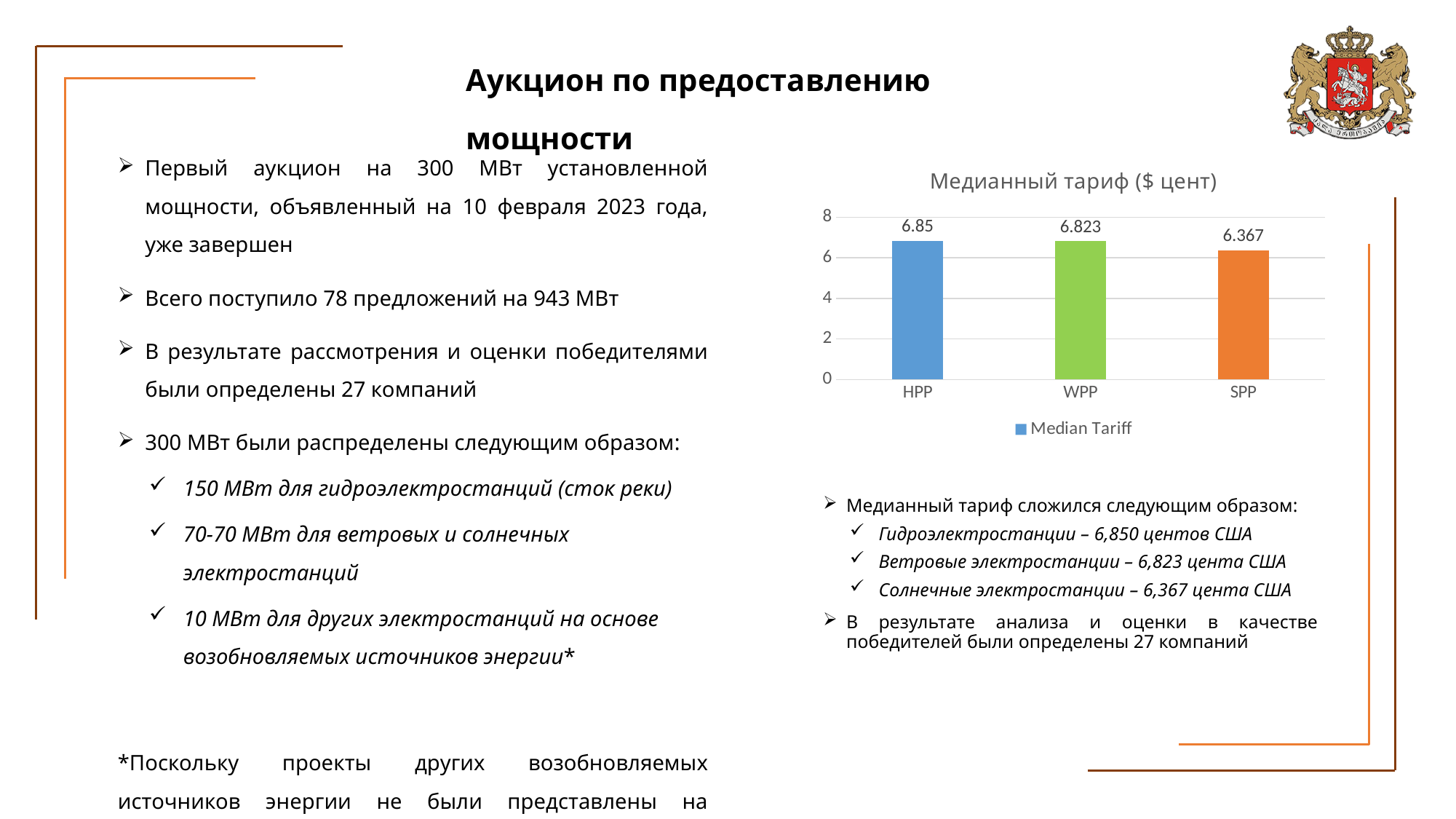
What is the median tariff value shown for SPP? 6.367 What is the median tariff value shown for HPP? 6.85 How many categories are shown on the x axis of the chart? 3 What kind of chart is shown on the slide? bar chart Which has a larger median tariff, HPP or SPP? HPP What is the difference between the median tariff for HPP and for SPP? 0.483 What is the title of the chart? Медианный тариф ($ цент) Which category has the lowest median tariff in the chart? SPP Is the value for SPP greater or less than 8? less What is the difference between the median tariff for WPP and for SPP? 0.456 How many series does the chart legend list? 1 What is the median tariff value shown for WPP? 6.823